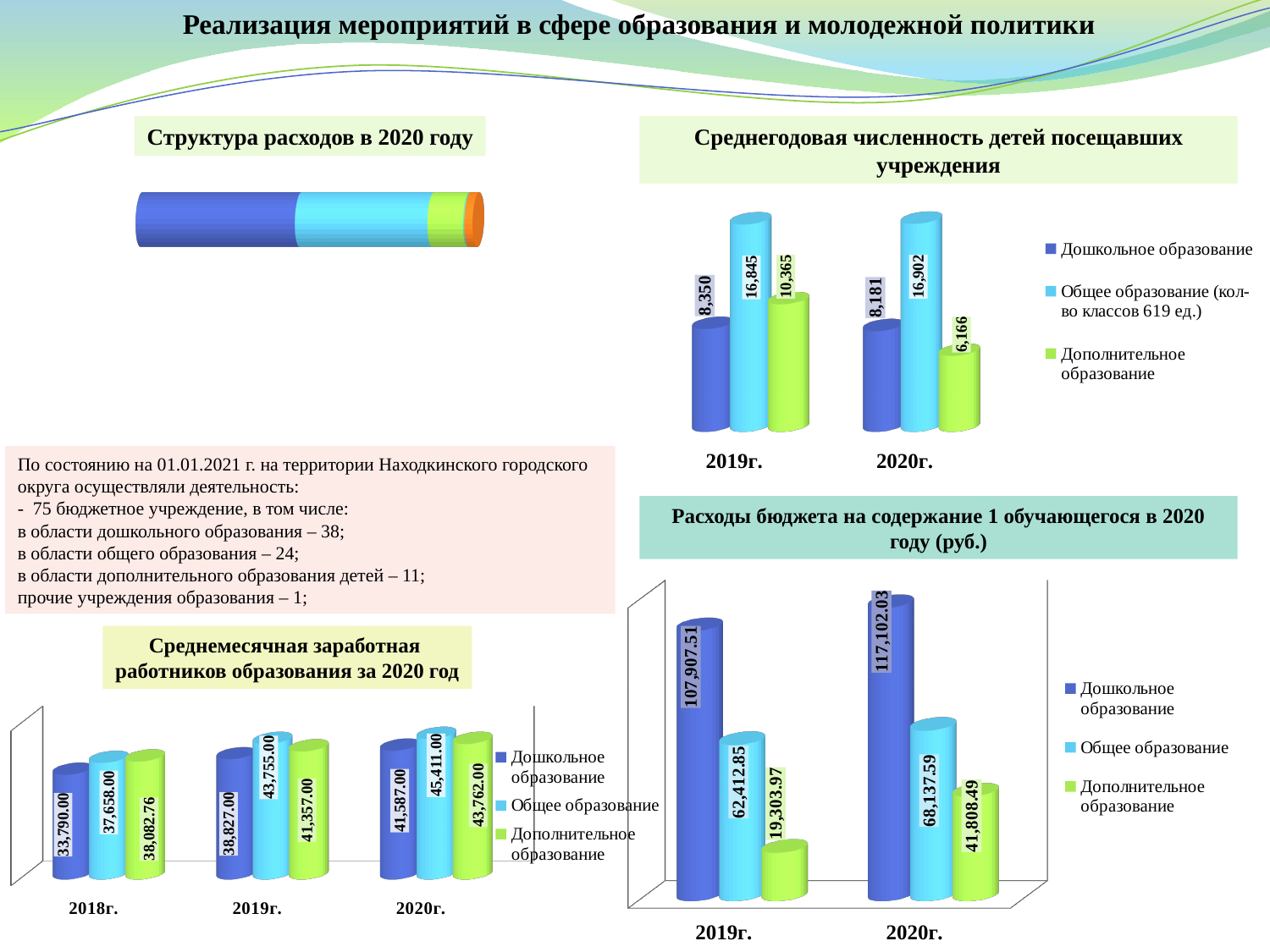
In the chart 'Среднегодовая численность детей посещавших учреждения', how many series does the legend list? 3 In the chart 'Среднегодовая численность детей посещавших учреждения', what is the value for Дошкольное образование in 2019г.? 8,350 In the chart 'Среднегодовая численность детей посещавших учреждения', what is the difference between Дополнительное образование in 2019г. and 2020г.? 4,199 In the chart 'Расходы бюджета на содержание 1 обучающегося в 2020 году (руб.)', what is the value for Дошкольное образование in 2020г.? 117,102.03 In the chart 'Среднемесячная заработная работников образования за 2020 год', does the value for Дошкольное образование rise or fall from 2018г. to 2020г.? rise In the chart 'Среднегодовая численность детей посещавших учреждения', which series has the highest value in 2020г.? Общее образование (кол-во классов 619 ед.) What kind of chart is 'Расходы бюджета на содержание 1 обучающегося в 2020 году (руб.)'? bar chart In the chart 'Расходы бюджета на содержание 1 обучающегося в 2020 году (руб.)', which is larger: Общее образование in 2019г. or Общее образование in 2020г.? Общее образование in 2020г. In the chart 'Среднемесячная заработная работников образования за 2020 год', how many year categories are shown on the x axis? 3 In the chart 'Среднегодовая численность детей посещавших учреждения', what is the value for Дополнительное образование in 2020г.? 6,166 In the chart 'Среднемесячная заработная работников образования за 2020 год', what is the value for Общее образование in 2019г.? 43,755.00 In the chart 'Среднемесячная заработная работников образования за 2020 год', which year has the lowest value for Дошкольное образование? 2018г.